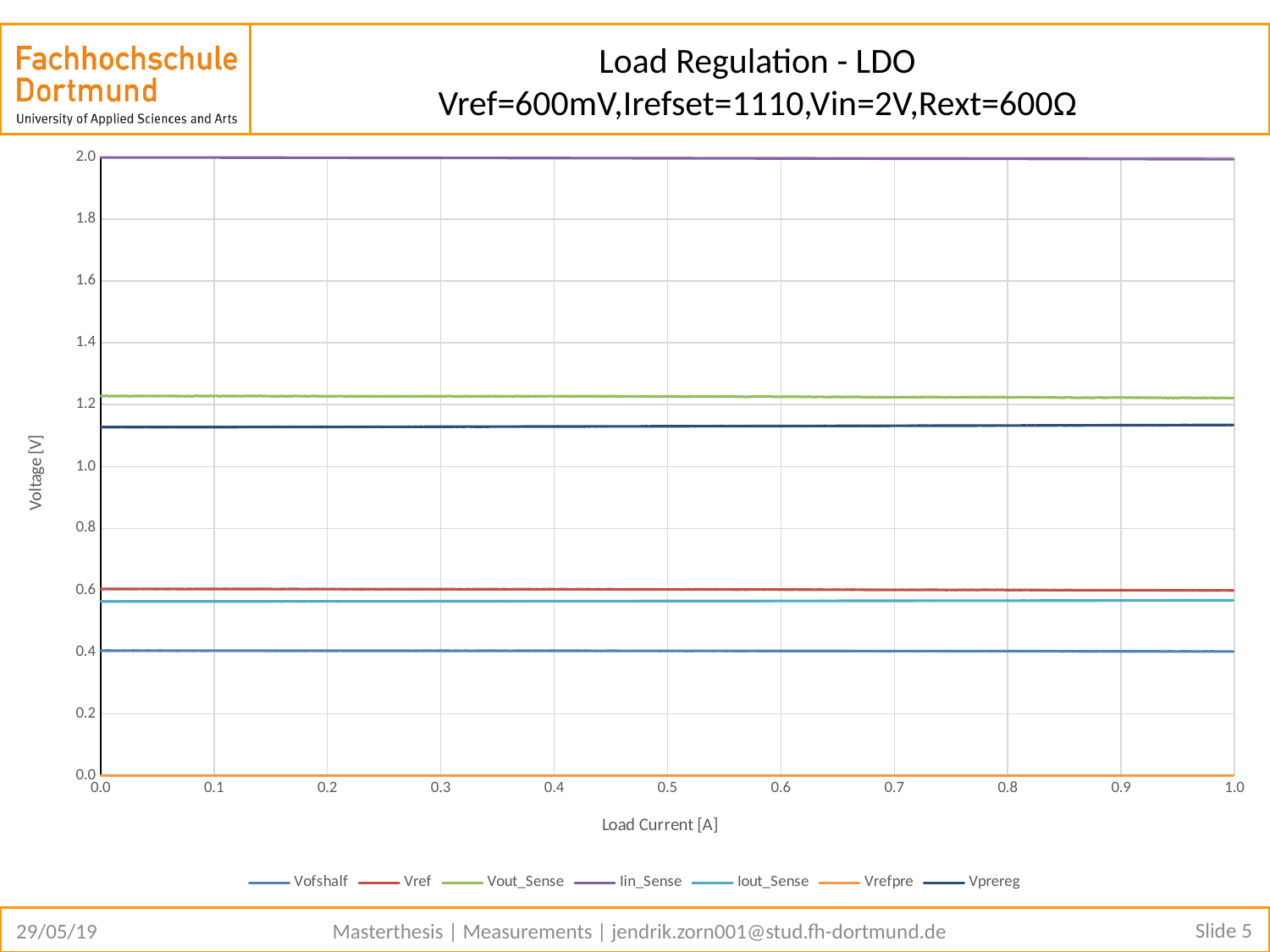
Which series has the lowest voltage across the load current range? Vrefpre Is the value for Vofshalf greater or less than 0.6 V? less Is the value for Iin_Sense greater or less than 1.8 V? greater Is the value for Vout_Sense greater or less than 1.0 V? greater How many series does the legend list? 7 Which is larger, Vref or Iout_Sense? Vref What is the label of the x axis? Load Current [A] What kind of chart is shown on the slide? line chart Does the Vref line rise, fall, or stay roughly constant as load current increases from 0.0 to 1.0 A? stays roughly constant Which series has the highest voltage across the load current range? Iin_Sense Which is larger, Vout_Sense or Vprereg? Vout_Sense